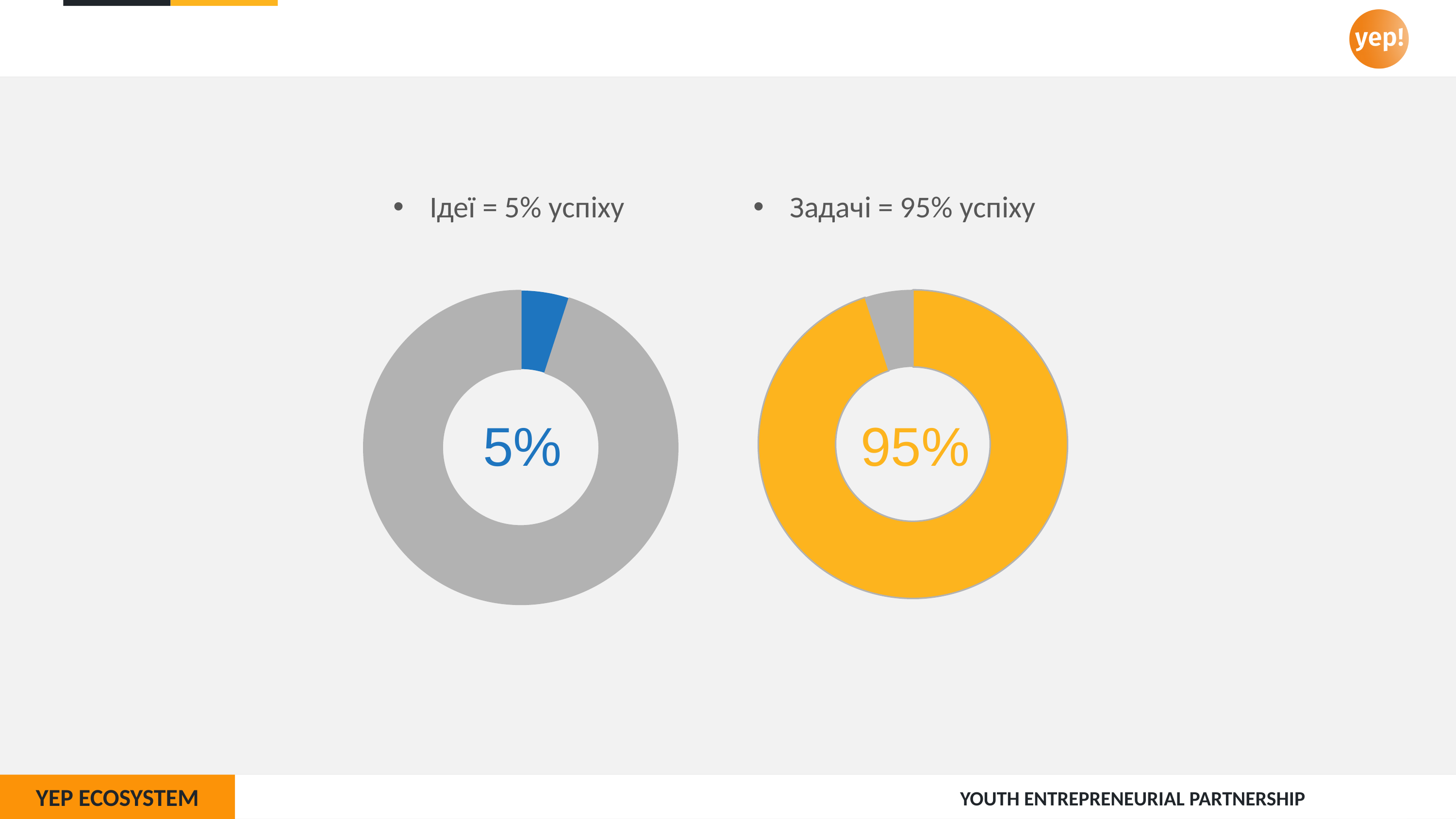
What colour is the highlighted slice in the left chart (Ідеї)? Blue According to the slide, what share of success do tasks (Задачі) account for? 95% In the right chart (Задачі), what percentage is printed in the centre? 95% What kind of chart is shown on the left side of the slide? Donut chart According to the slide, what share of success do ideas (Ідеї) account for? 5% What colour is the highlighted slice in the right chart (Задачі)? Yellow What kind of chart is shown on the right side of the slide? Donut chart In the left chart (Ідеї), what percentage is printed in the centre? 5% Is the highlighted share in the left chart (Ідеї) greater or less than 50%? less What is the difference between the percentage shown in the right chart (Задачі) and the percentage shown in the left chart (Ідеї)? 90% How many donut charts are on the slide? 2 Which is larger: the highlighted share in the left chart (Ідеї) or in the right chart (Задачі)? Задачі